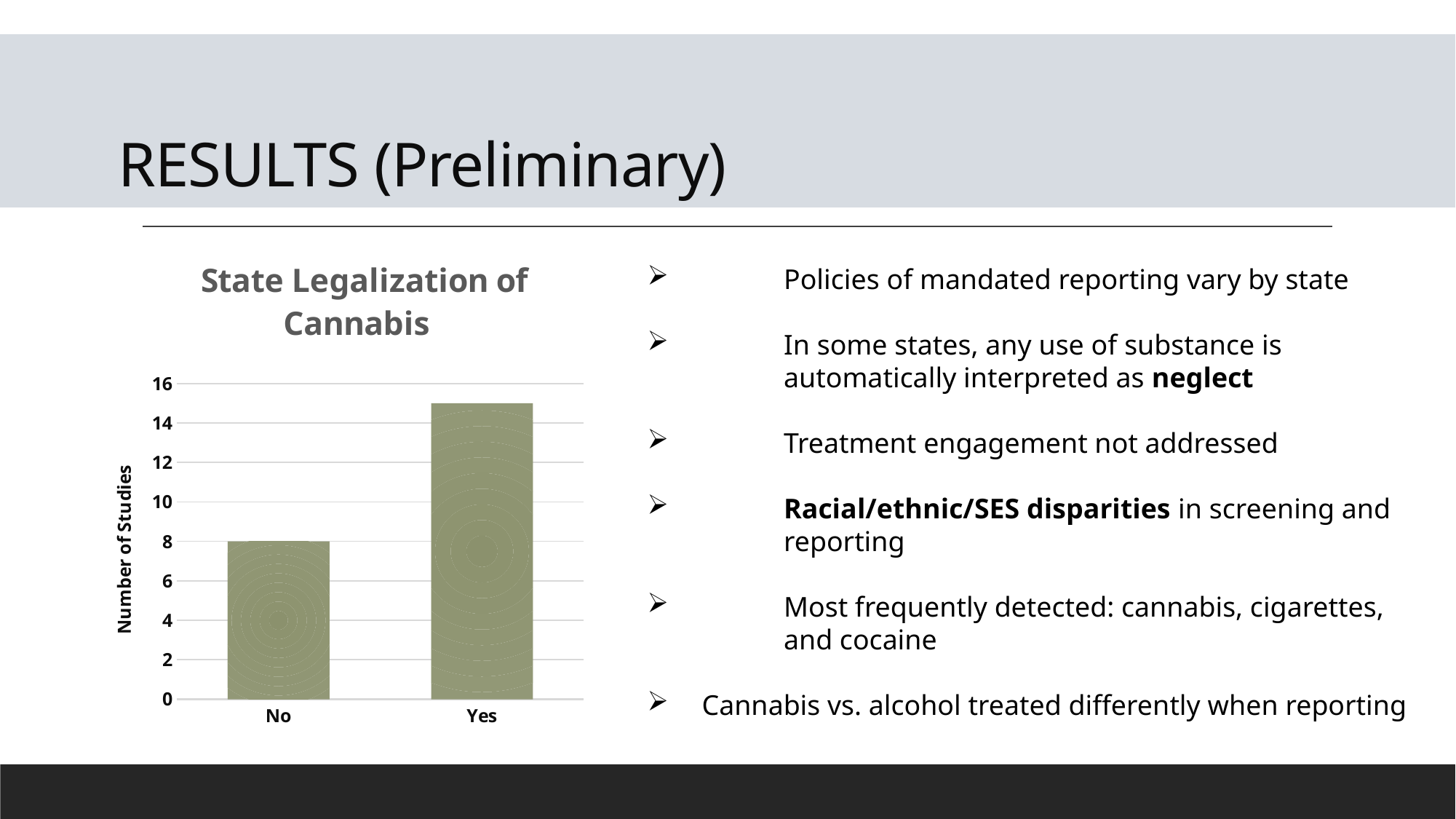
What type of chart is shown on the slide? bar chart What is the label of the vertical axis of the chart? Number of Studies Which category has the highest number of studies? Yes Which has more studies, 'No' or 'Yes'? Yes Do the values rise or fall from 'No' to 'Yes' along the x axis? rise How many categories are shown on the x axis of the chart? 2 What is the title of the chart? State Legalization of Cannabis Is the value for 'No' greater or less than 10? less What is the number of studies for the 'No' category? 8 Is the value for 'Yes' greater or less than 16? less Which category has the lowest number of studies? No Is the value for 'Yes' greater or less than 14? greater